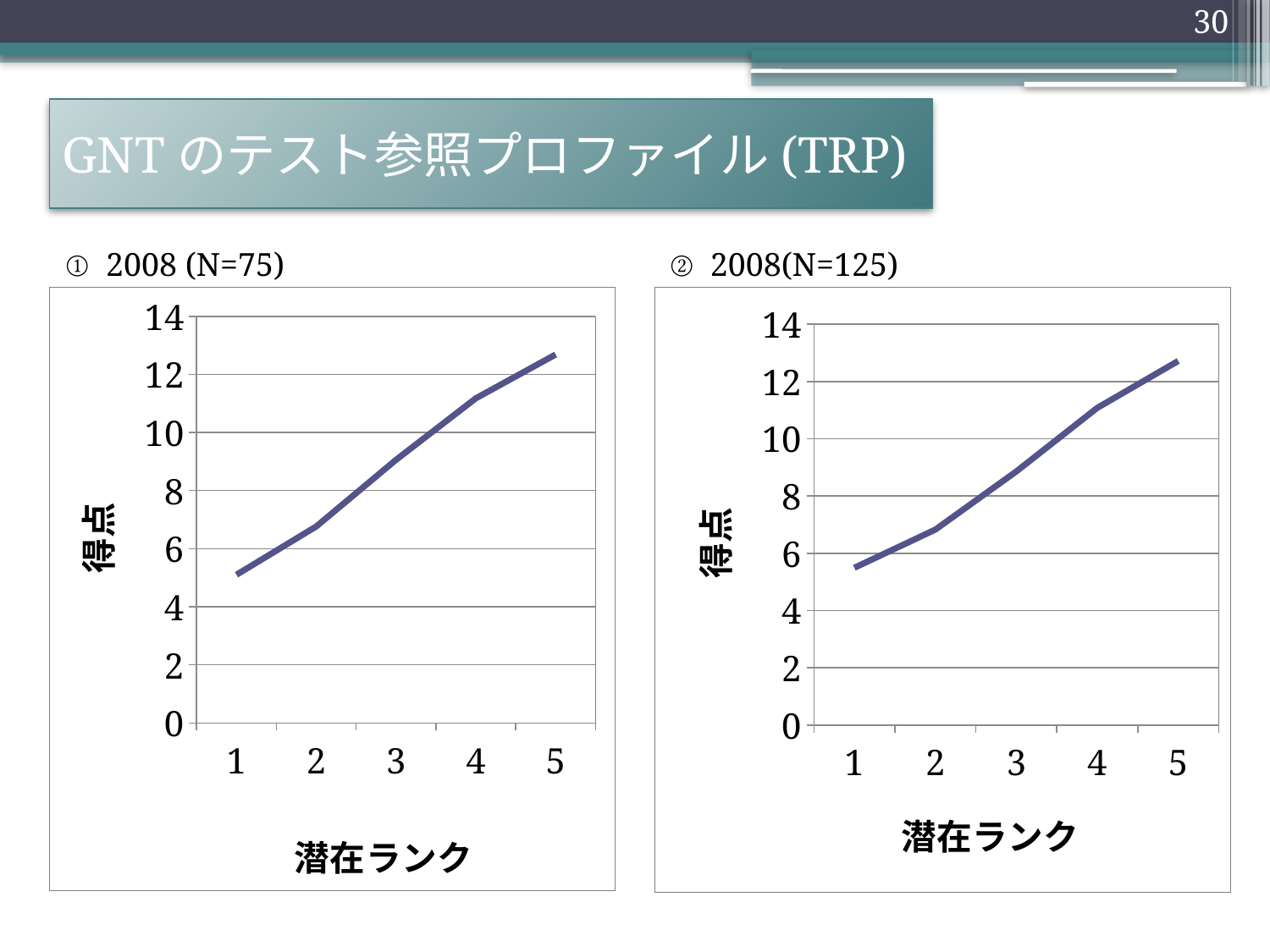
In the left chart (2008, N=75), which 潜在ランク has the highest 得点? 5 In the right chart (2008, N=125), which 潜在ランク has the lowest 得点? 1 In the left chart (2008, N=75), do the 得点 values rise or fall as 潜在ランク increases from 1 to 5? rise In the right chart (2008, N=125), how many 潜在ランク categories are shown on the x axis? 5 In the right chart (2008, N=125), do the 得点 values rise or fall as 潜在ランク increases from 1 to 5? rise What kind of chart is the right chart labelled 2008(N=125)? line chart In the right chart (2008, N=125), is the 得点 value for 潜在ランク 5 greater or less than 12? greater What is the y-axis label on both charts? 得点 In the left chart (2008, N=75), is the 得点 value for 潜在ランク 3 greater or less than 8? greater In the left chart (2008, N=75), is the 得点 value for 潜在ランク 1 greater or less than 6? less What kind of chart is the left chart labelled 2008 (N=75)? line chart In the left chart (2008, N=75), how many 潜在ランク categories are shown on the x axis? 5